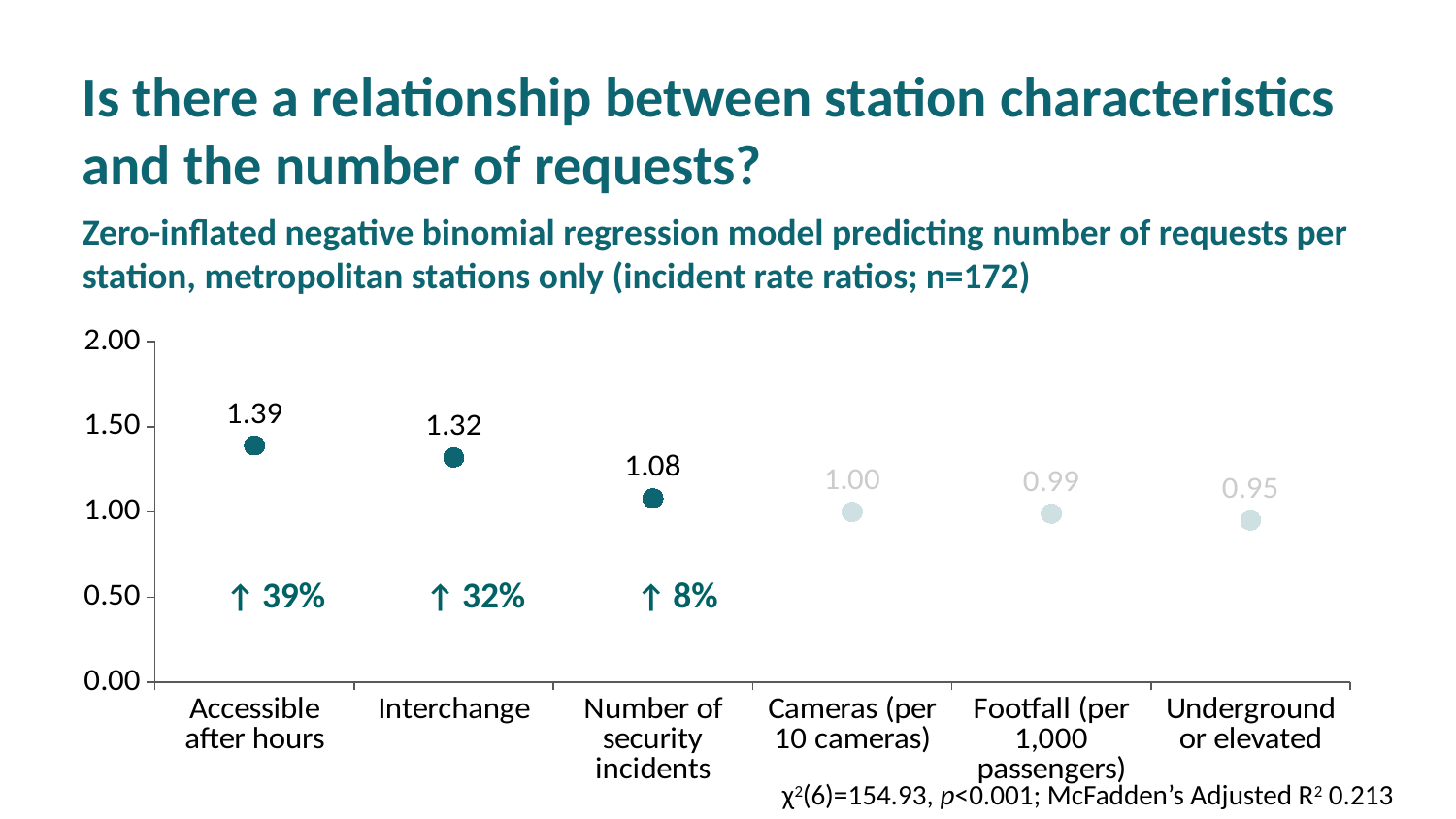
What is the incident rate ratio for Interchange? 1.32 How many station characteristics are plotted on the chart? 6 What is the incident rate ratio for Accessible after hours? 1.39 Which station characteristic has the highest incident rate ratio? Accessible after hours Which has a larger incident rate ratio, Interchange or Number of security incidents? Interchange What is the incident rate ratio for Number of security incidents? 1.08 Is the value for Accessible after hours greater or less than 1.50? less What percentage increase is annotated for Interchange? ↑ 32% What is the difference between the incident rate ratios for Accessible after hours and Interchange? 0.07 Which station characteristic has the lowest incident rate ratio? Underground or elevated What kind of chart is shown on the slide? Dot plot (scatter chart) What is the incident rate ratio for Underground or elevated? 0.95